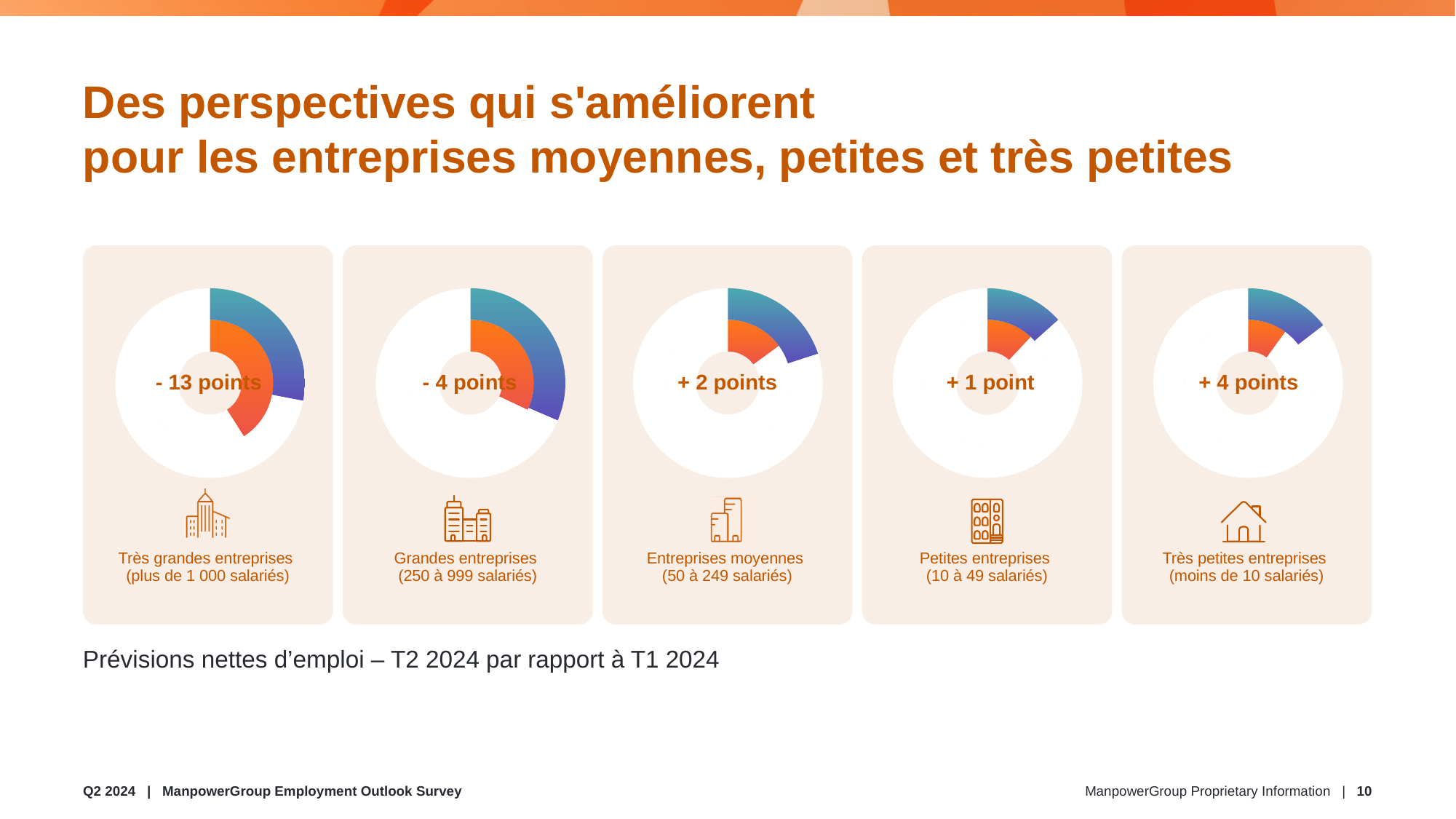
What change in points is shown for 'Entreprises moyennes (50 à 249 salariés)'? + 2 points What is the difference between the change shown for 'Très petites entreprises' (+ 4 points) and 'Petites entreprises' (+ 1 point)? 3 points What change in points is shown for 'Très petites entreprises (moins de 10 salariés)'? + 4 points What change in points is shown for 'Petites entreprises (10 à 49 salariés)'? + 1 point Which company size category shows the largest positive change in points? Très petites entreprises (moins de 10 salariés) What comparison period is described in the caption below the charts? T2 2024 par rapport à T1 2024 What kind of chart is used for each company size category? Donut chart What change in points is shown for 'Très grandes entreprises (plus de 1 000 salariés)'? - 13 points Which shows a larger positive change: 'Entreprises moyennes' or 'Petites entreprises'? Entreprises moyennes How many company size categories are shown on the slide? 5 What change in points is shown for 'Grandes entreprises (250 à 999 salariés)'? - 4 points Which company size category shows the largest decline in points? Très grandes entreprises (plus de 1 000 salariés)